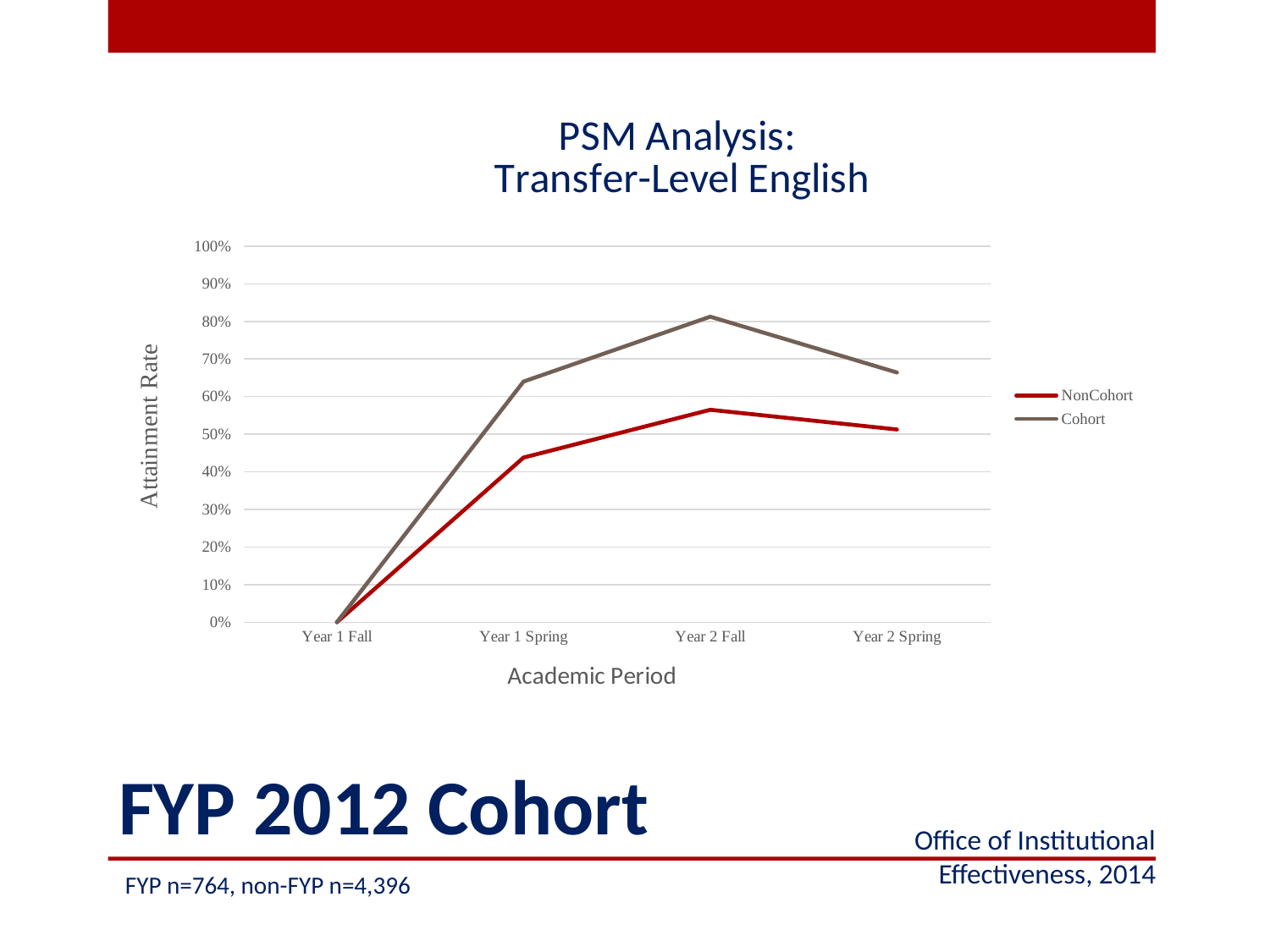
Is the Cohort attainment rate at Year 2 Spring greater or less than 60%? greater How many academic periods are plotted along the x axis? 4 What is the attainment rate for the NonCohort series at Year 1 Fall? 0% What is the attainment rate for the Cohort series at Year 1 Fall? 0% What type of chart is shown on the slide? line chart At which academic period does the Cohort series reach its highest attainment rate? Year 2 Fall What is the title of the chart? PSM Analysis: Transfer-Level English At which academic period does the NonCohort series reach its highest attainment rate? Year 2 Fall At Year 2 Spring, which series has the higher attainment rate, Cohort or NonCohort? Cohort How many series does the legend list? 2 Is the Cohort attainment rate at Year 2 Fall greater or less than 80%? greater Is the NonCohort attainment rate at Year 1 Spring greater or less than 50%? less